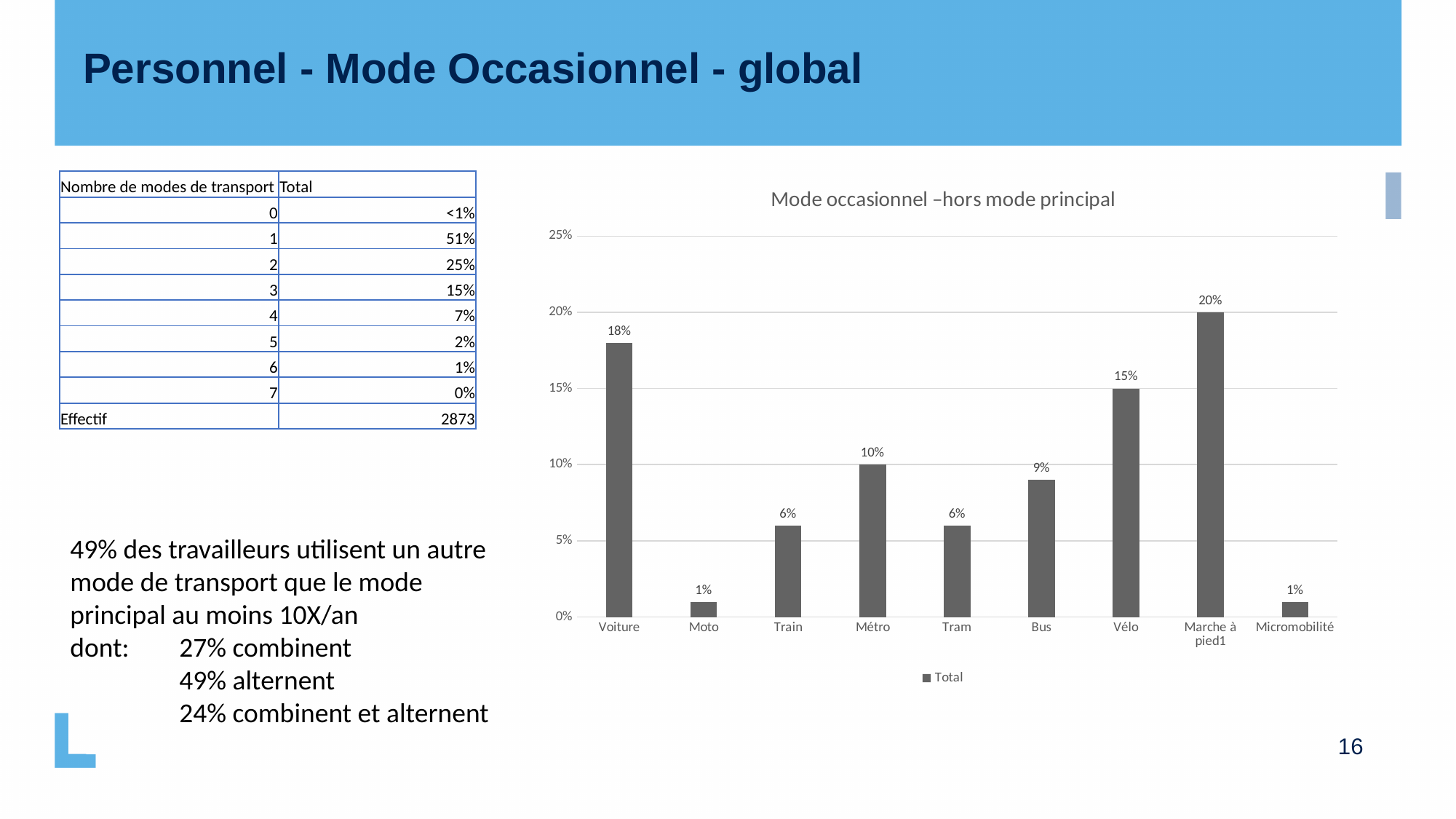
How many categories are shown on the x axis of the chart? 9 What is the value for Voiture in the chart? 18% What is the value for Vélo in the chart? 15% What is the difference between the values for Marche à pied1 and Voiture? 2% Which category has the highest value in the chart? Marche à pied1 How many series does the chart legend list? 1 What is the value for Bus in the chart? 9% Is the value for Vélo greater or less than 10%? greater What is the title of the chart? Mode occasionnel –hors mode principal What is the name of the series listed in the chart legend? Total Which is larger, the value for Métro or the value for Bus? Métro What kind of chart is shown on the slide? bar chart